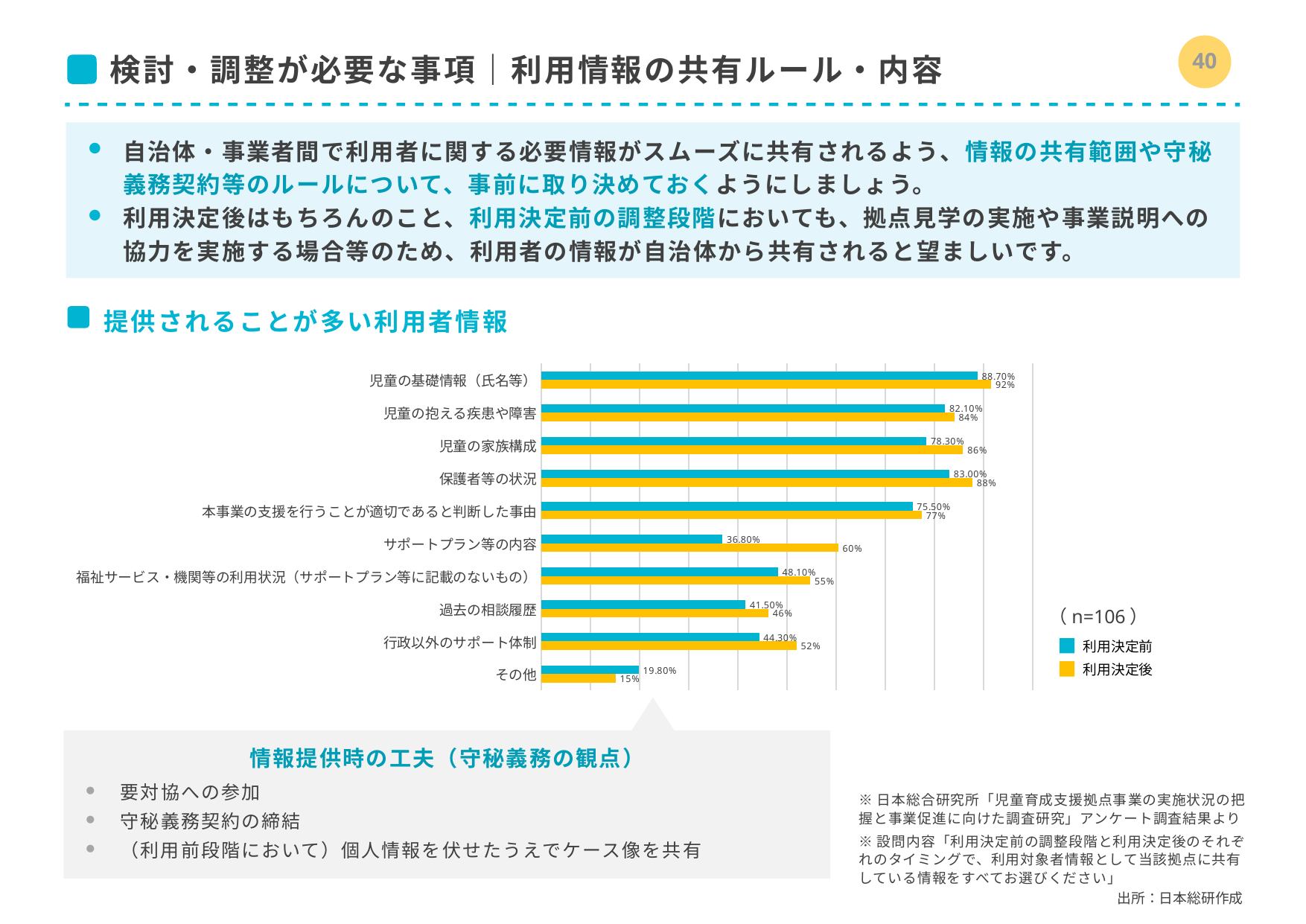
What is the 利用決定前 value for 児童の基礎情報（氏名等）? 88.70% For その他, which is larger: the 利用決定前 value or the 利用決定後 value? 利用決定前 Which category has the highest 利用決定後 value? 児童の基礎情報（氏名等） What is the 利用決定後 value for サポートプラン等の内容? 60% What kind of chart is shown on the slide? Bar chart For 利用決定前, which is larger: 児童の家族構成 or 保護者等の状況? 保護者等の状況 What is the 利用決定前 value for 行政以外のサポート体制? 44.30% How many series does the legend list? 2 How many categories are shown in the chart? 10 What is the difference between the 利用決定後 and 利用決定前 values for サポートプラン等の内容? 23.2 percentage points What sample size (n) is shown next to the chart legend? n=106 Which category has the lowest 利用決定前 value? その他